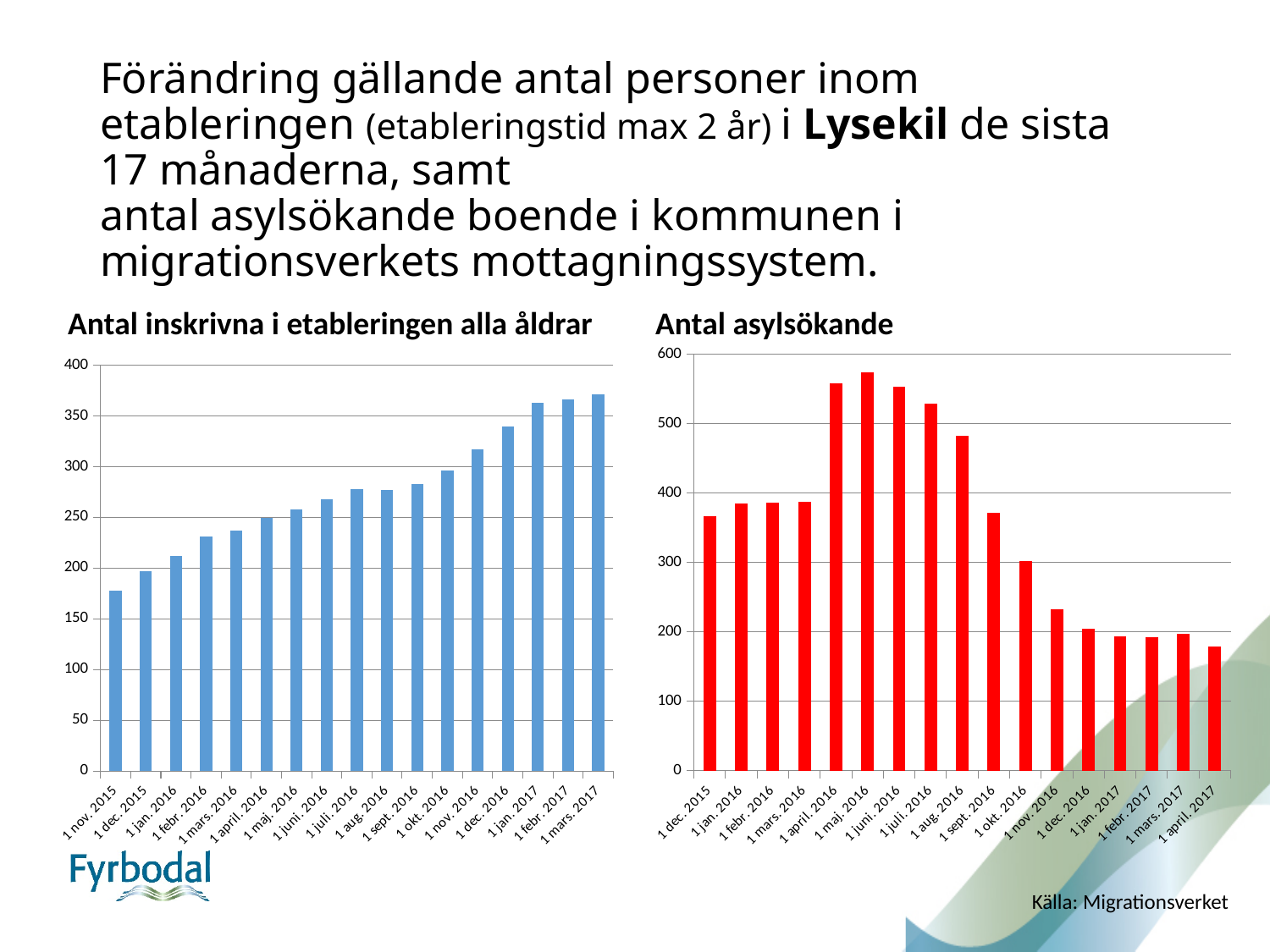
In the 'Antal inskrivna i etableringen alla åldrar' chart, is the value for 1 mars. 2017 greater or less than 350? greater In the 'Antal inskrivna i etableringen alla åldrar' chart, which month has the highest value? 1 mars. 2017 In the 'Antal inskrivna i etableringen alla åldrar' chart, do the values generally rise or fall from left to right? rise In the 'Antal inskrivna i etableringen alla åldrar' chart, is the value for 1 nov. 2015 greater or less than 200? less In the 'Antal asylsökande' chart, which month has the lowest value? 1 april. 2017 In the 'Antal asylsökande' chart, is the value for 1 nov. 2016 greater or less than 300? less What colour are the bars in the 'Antal asylsökande' chart? Red In the 'Antal inskrivna i etableringen alla åldrar' chart, which month has the lowest value? 1 nov. 2015 In the 'Antal asylsökande' chart, which month has the highest value? 1 maj. 2016 In the 'Antal asylsökande' chart, which is larger, the value for 1 april. 2016 or the value for 1 dec. 2015? 1 april. 2016 In the 'Antal inskrivna i etableringen alla åldrar' chart, how many bars (months) are plotted? 17 What type of chart is the 'Antal inskrivna i etableringen alla åldrar' chart? Bar chart